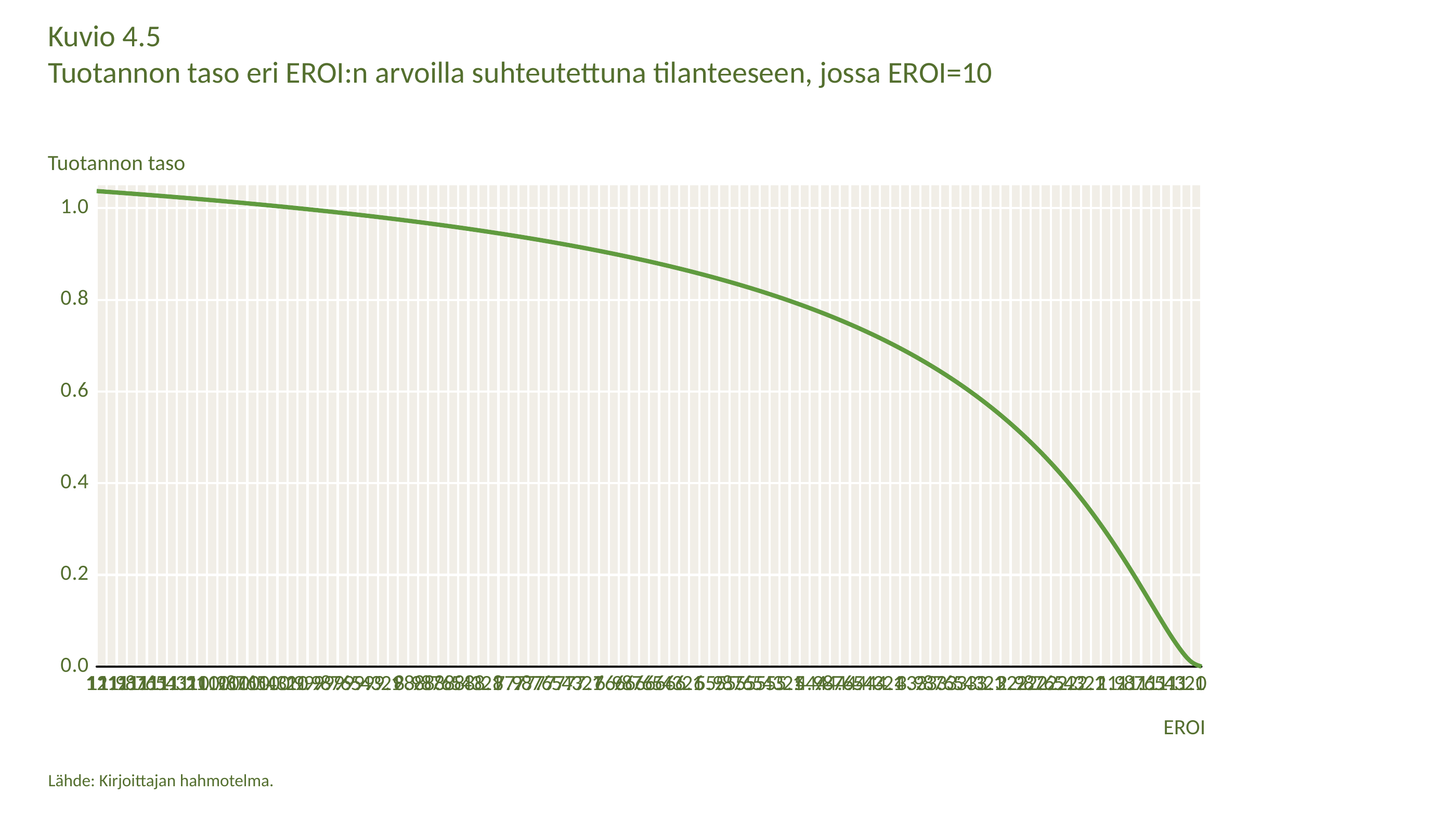
At the horizontal midpoint of the chart, is the value of the line greater or less than 0.8? greater Which end of the x axis has the higher value of the line, the left end or the right end? left end At the left end of the x axis, is the value of the line greater or less than 0.8? greater What kind of chart is shown on the slide? line chart What value does the line reach at the right end of the x axis? 0.0 What is the title of the chart? Tuotannon taso eri EROI:n arvoilla suhteutettuna tilanteeseen, jossa EROI=10 Is the value of the line at the right end of the x axis greater or less than 0.2? less What label is given to the vertical axis of the chart? Tuotannon taso Does the plotted line rise or fall from left to right along the x axis? fall